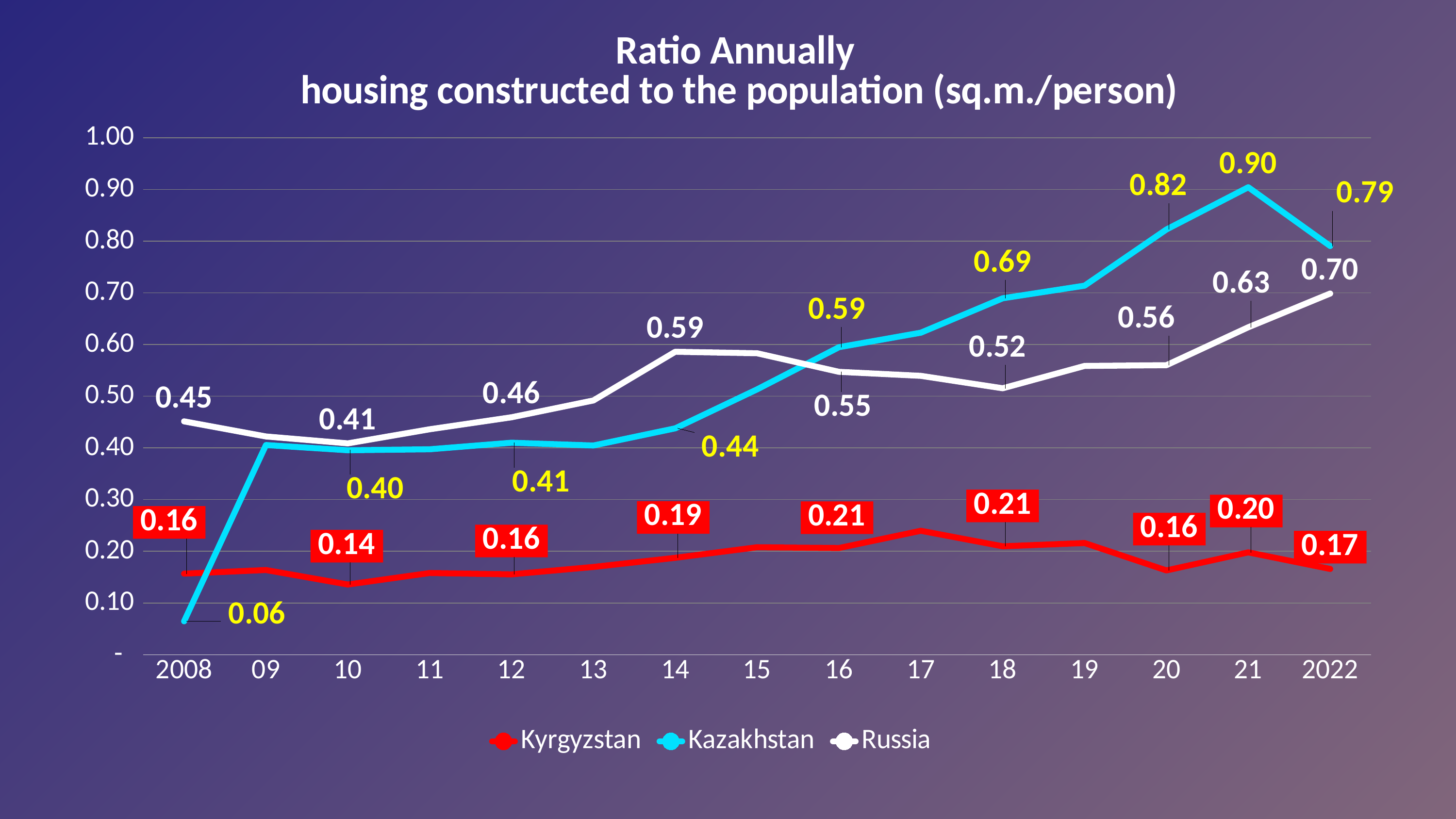
Does the Kazakhstan line rise or fall from 2008 to 2021? rise What is the value for Kazakhstan in 2022? 0.79 What kind of chart is shown on the slide? line chart How many years are shown on the x axis? 15 In which year is the Kazakhstan value lowest? 2008 In 2016, which is larger: the value for Kazakhstan or for Russia? Kazakhstan What is the value for Kyrgyzstan in 2014? 0.19 In which year does Kazakhstan reach its highest value? 21 Is the value for Russia in 2015 greater or less than 0.50? greater What is the value for Russia in 2008? 0.45 What is the difference between the Kazakhstan and Russia values in 2022? 0.09 How many series does the legend list? 3